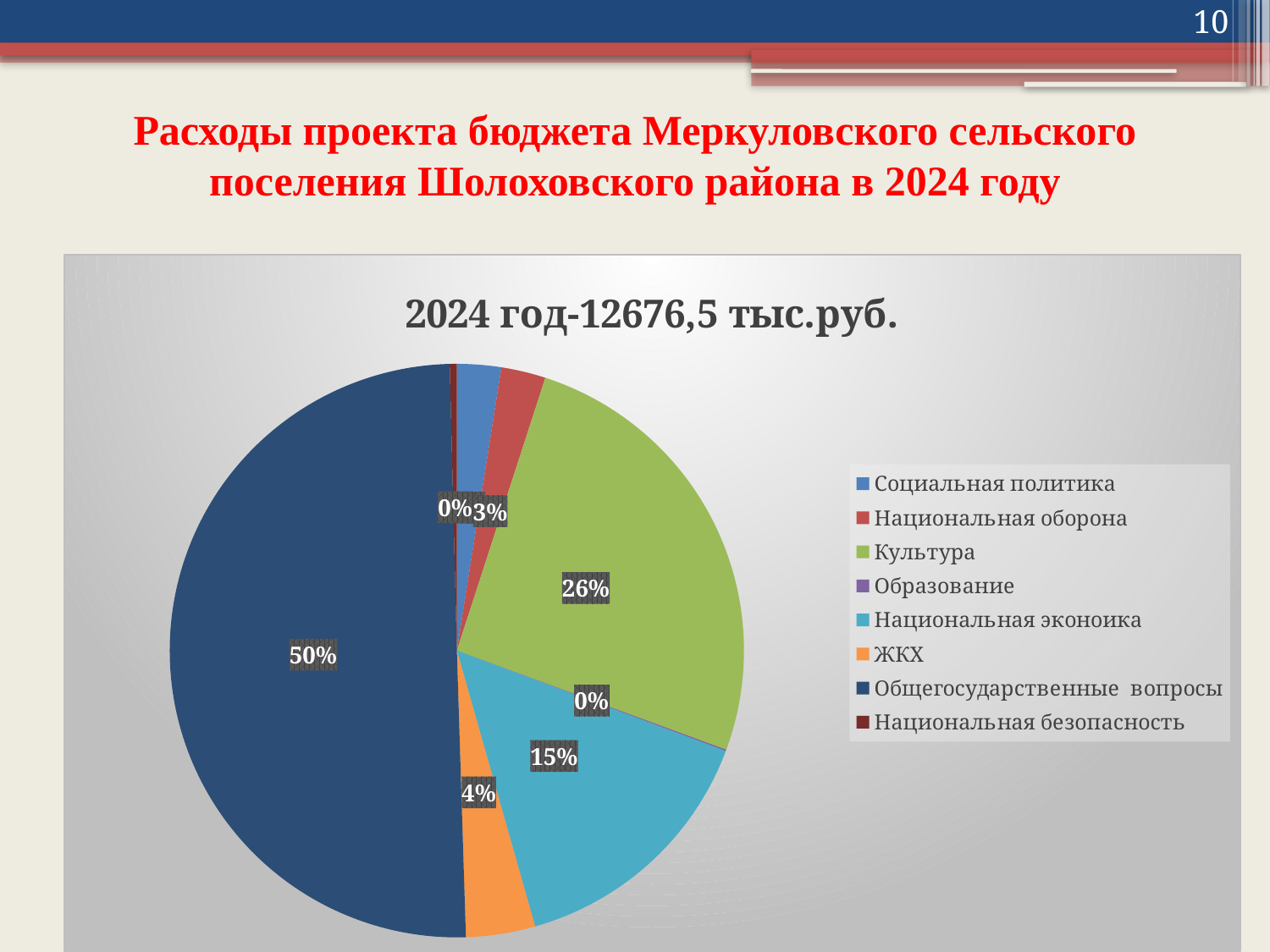
What share of the pie does Национальная экономика take? 15% What share of the pie does Культура take? 26% What type of chart is shown on the slide? pie chart Which category has the largest share of the pie? Общегосударственные вопросы What colour is the slice for Культура? green Which is larger, the share for ЖКХ or the share for Национальная экономика? Национальная экономика By how many percentage points does the share for Общегосударственные вопросы exceed the share for Культура? 24 Which is larger, the share for Культура or the share for Национальная экономика? Культура What is the title of the chart? 2024 год-12676,5 тыс.руб. What share of the pie does ЖКХ take? 4% How many categories does the chart's legend list? 8